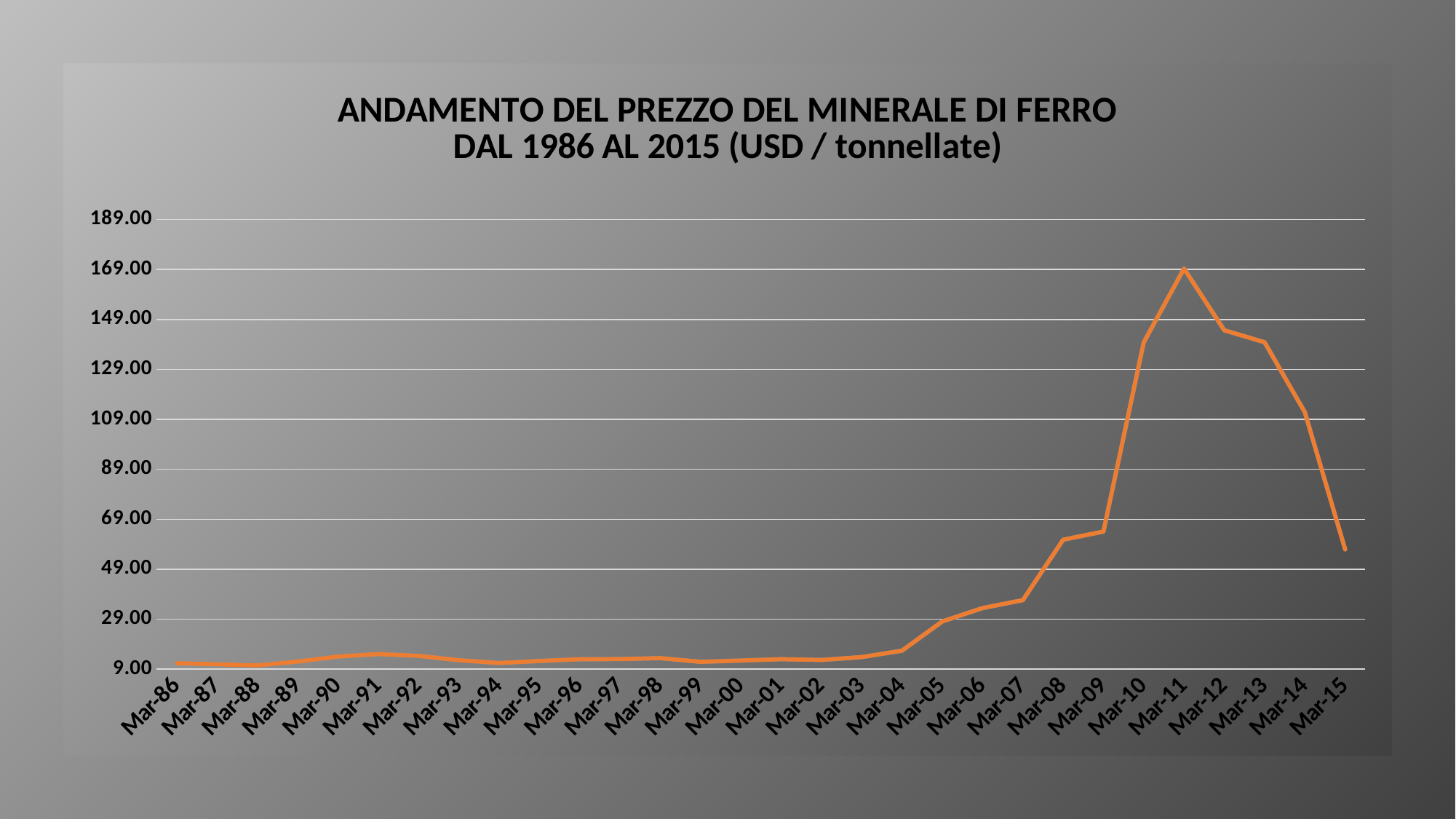
Is the value for Mar-14 greater or less than 89.00? greater Is the value for Mar-15 greater or less than 69.00? less What is the title of the chart? ANDAMENTO DEL PREZZO DEL MINERALE DI FERRO DAL 1986 AL 2015 (USD / tonnellate) How many data points (years) are plotted along the x axis? 30 Which is larger, the value for Mar-13 or the value for Mar-14? Mar-13 Is the value for Mar-11 greater or less than 149.00? greater At which date does the iron ore price reach its highest value? Mar-11 Do the values rise or fall from Mar-11 to Mar-15? fall What kind of chart is shown on the slide? line chart Which is larger, the value for Mar-08 or the value for Mar-07? Mar-08